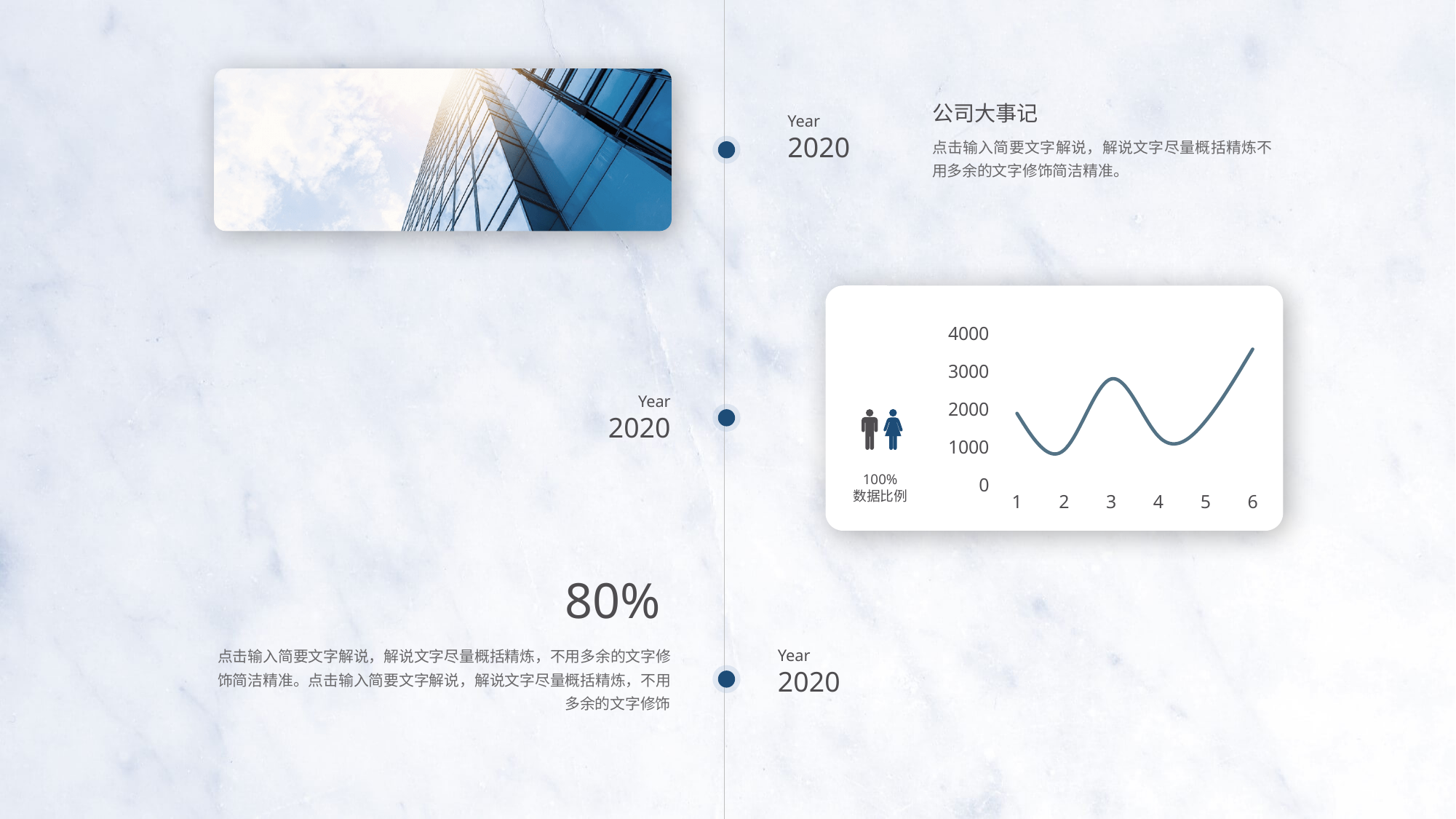
How many points are plotted along the x axis of the line chart? 6 Is the value at x = 6 greater or less than 3000? greater Is the value at x = 1 greater or less than 1000? greater What kind of chart is shown on the slide? line chart At which x-axis category does the line reach its lowest value? 2 Which has the larger value, x = 3 or x = 6? 6 Is the value at x = 4 greater or less than 2000? less At which x-axis category does the line reach its highest value? 6 Which has the larger value, x = 1 or x = 4? 1 What is the highest value shown on the y axis of the line chart? 4000